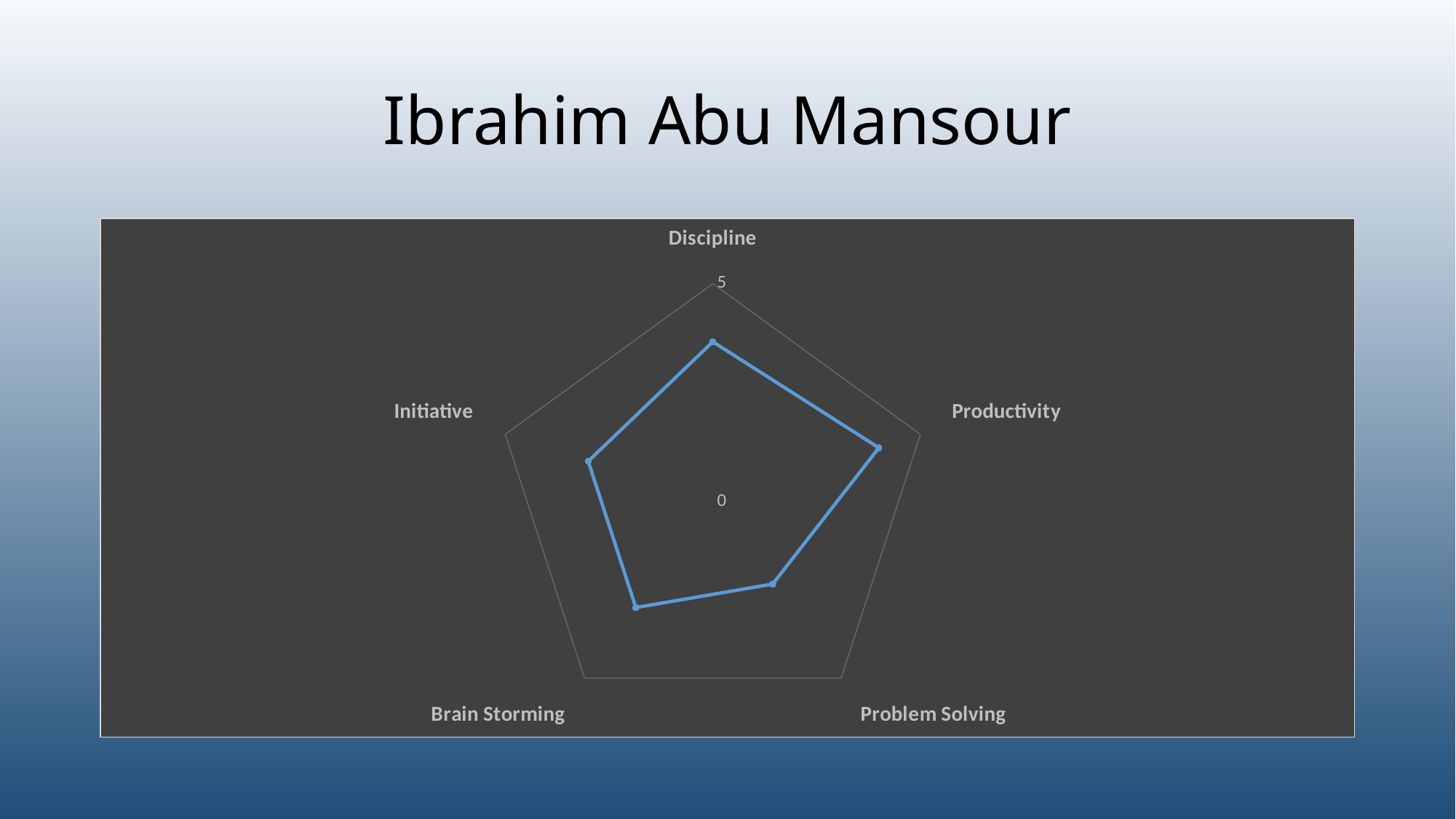
Is the value for Problem Solving on the radar chart greater or less than 0? greater Which is larger on the radar chart, the value for Initiative or the value for Problem Solving? Initiative How many categories (axes) does the radar chart have? 5 Which is larger on the radar chart, the value for Discipline or the value for Problem Solving? Discipline Which is larger on the radar chart, the value for Productivity or the value for Problem Solving? Productivity Is the value for Productivity on the radar chart greater or less than 5? less Which category label appears at the top of the radar chart? Discipline Which category has the lowest value on the radar chart? Problem Solving What kind of chart is shown on the slide? Radar chart What is the maximum value shown on the radar chart's axis scale? 5